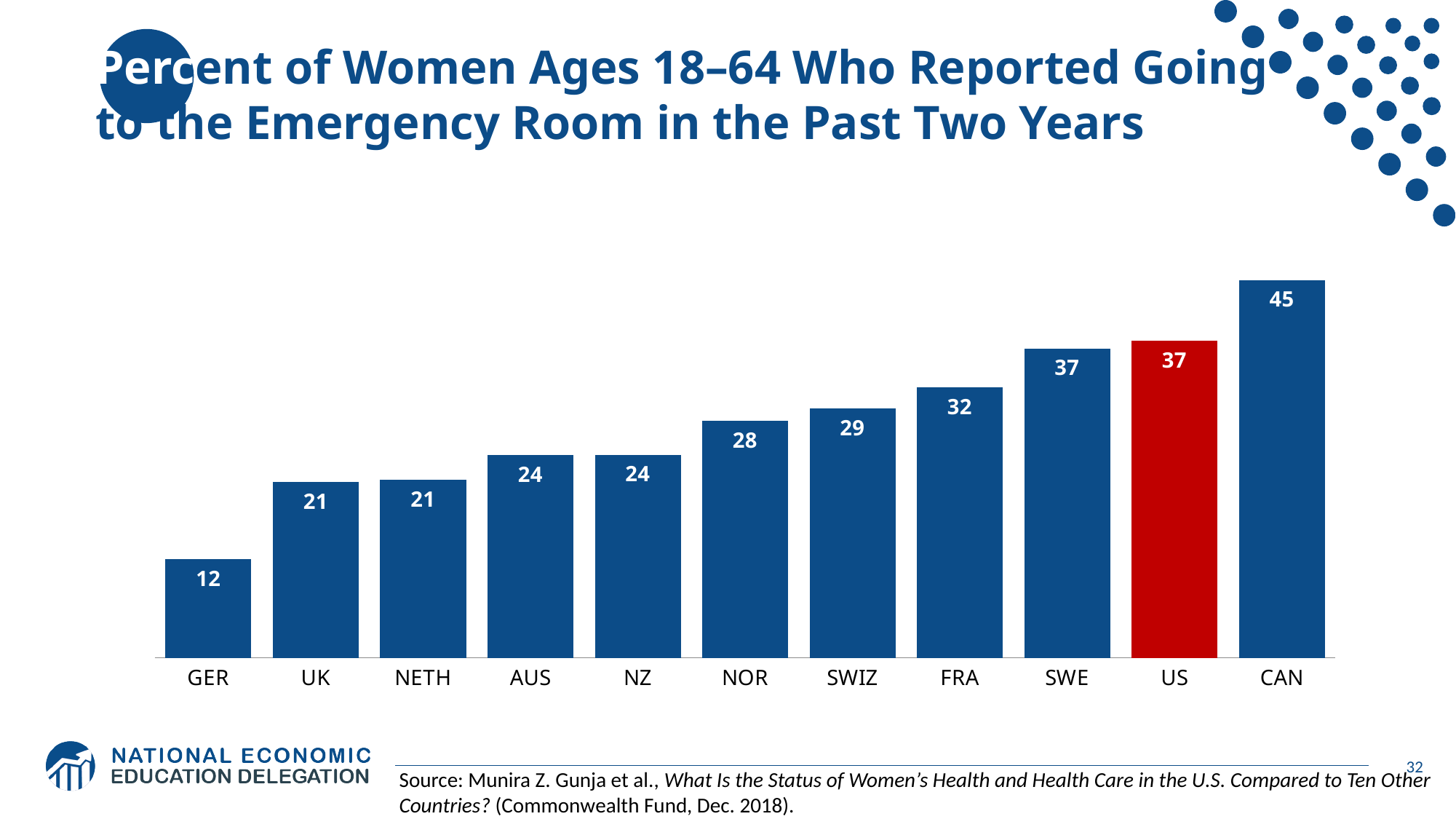
Which country has the lowest value? GER What is the value for the US? 37 Which is larger, the value for SWIZ or the value for AUS? SWIZ How many countries are shown on the chart? 11 What is the value for GER? 12 What is the value for NOR? 28 What is the difference between the values for FRA and UK? 11 What is the difference between the values for CAN and the US? 8 Which bar is coloured red? US Which country has the highest value? CAN What kind of chart is this? bar chart Do the values rise or fall from left to right along the x axis? rise